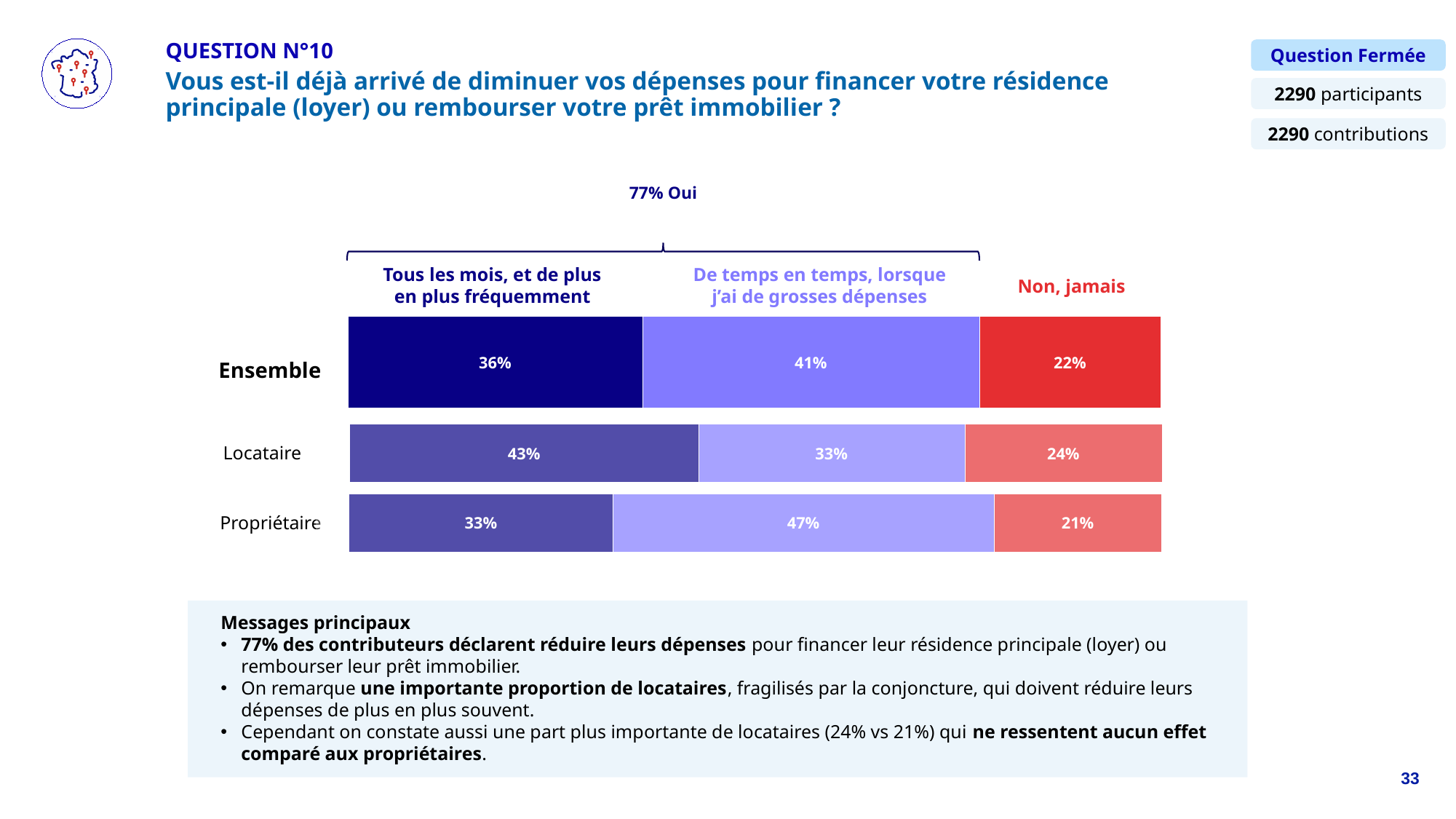
Which group has the highest share answering "Tous les mois, et de plus en plus fréquemment"? Locataire How many answer categories does the chart show? 3 Which group has the lowest share answering "Non, jamais"? Propriétaire What is the difference between the Locataire and Propriétaire shares for "Non, jamais"? 3% How many groups (rows) are shown in the chart? 3 What percentage of the Ensemble group answered "Tous les mois, et de plus en plus fréquemment"? 36% What colour is used for the "Non, jamais" category? Red Which is larger: the Locataire share for "De temps en temps, lorsque j'ai de grosses dépenses" or the Propriétaire share for the same answer? Propriétaire What kind of chart is shown on the slide? Stacked bar chart What percentage of Locataire respondents answered "Non, jamais"? 24% What is the total of the Ensemble bar's "Tous les mois" and "De temps en temps" segments? 77% What percentage of Propriétaire respondents answered "De temps en temps, lorsque j'ai de grosses dépenses"? 47%